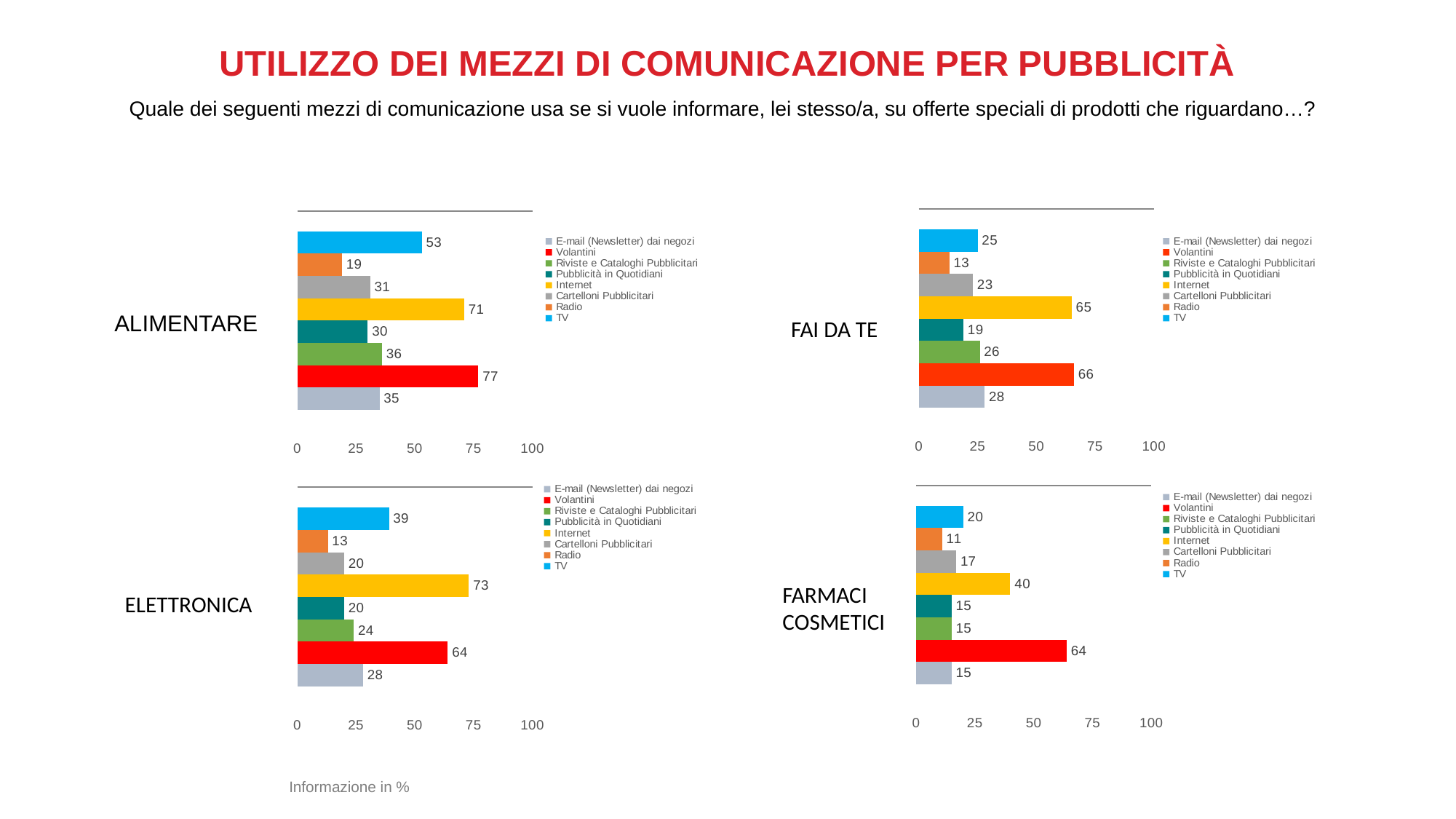
In the ELETTRONICA chart, which medium has the highest value? Internet In the ELETTRONICA chart, what is the value for TV? 39 In the ALIMENTARE chart, what is the difference between Internet and Cartelloni Pubblicitari? 40 In the FAI DA TE chart, what is the value for Internet? 65 What kind of chart is the ELETTRONICA chart? Bar chart In the FAI DA TE chart, what is the difference between Volantini and Radio? 53 In the ALIMENTARE chart, what is the value for Volantini? 77 How many series does the legend of the ALIMENTARE chart list? 8 In the ALIMENTARE chart, which medium has the lowest value? Radio In the FARMACI COSMETICI chart, what is the value for Radio? 11 In the FARMACI COSMETICI chart, is the value for Volantini greater or less than 50? greater In the FARMACI COSMETICI chart, which is larger, Internet or TV? Internet